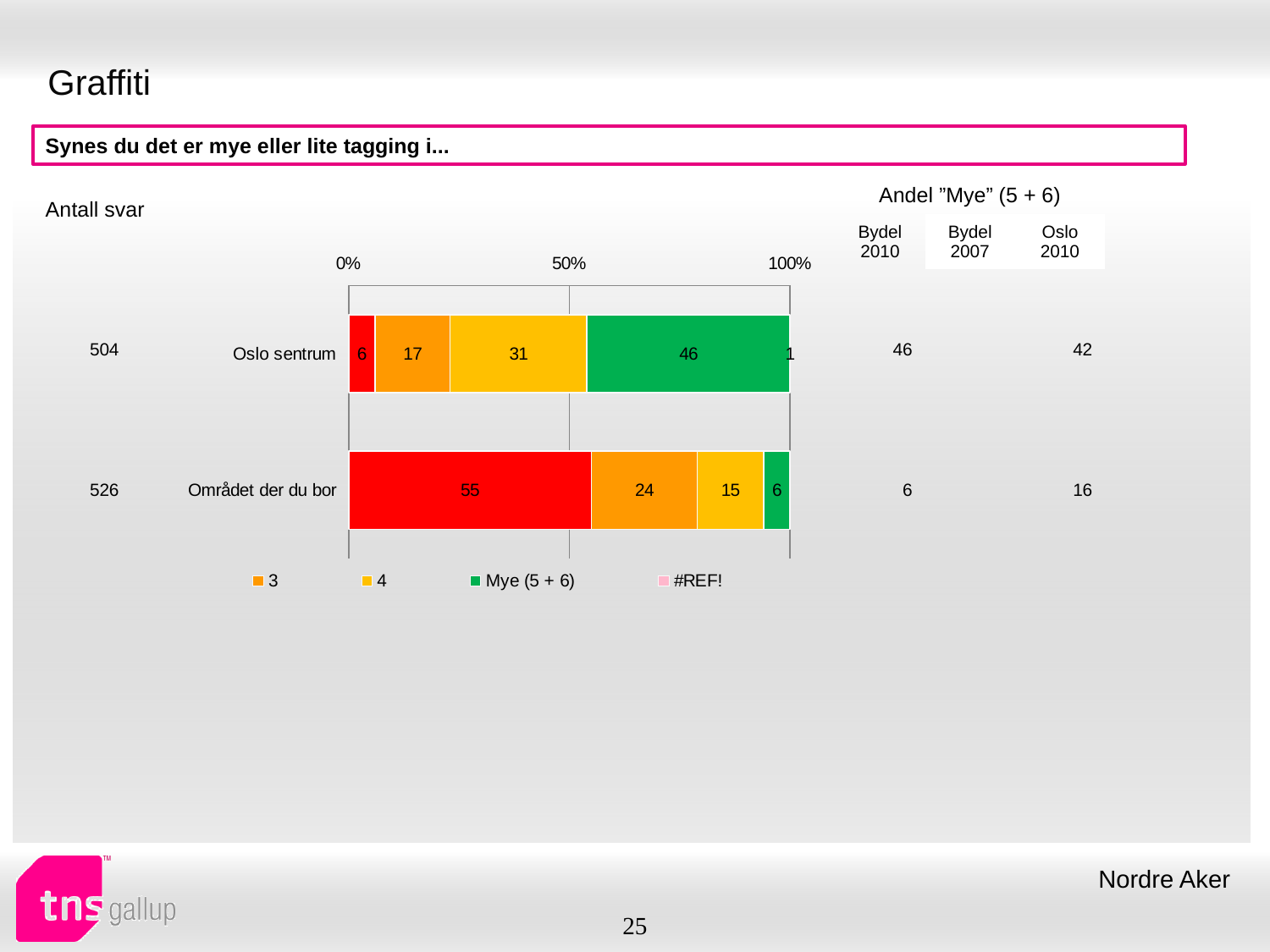
What is the value of the '3' segment for Området der du bor? 24 What is the value of the red segment for Området der du bor? 55 What is the value of the '4' segment for Oslo sentrum? 31 In the 'Andel "Mye" (5 + 6)' table, what is the Oslo 2010 value for Oslo sentrum? 42 Which category has the larger 'Mye (5 + 6)' segment, Oslo sentrum or Området der du bor? Oslo sentrum What is the value of the 'Mye (5 + 6)' segment for Oslo sentrum? 46 How many categories are plotted in the bar chart? 2 What is the difference between the 'Mye (5 + 6)' values for Oslo sentrum and Området der du bor? 40 What is the value of the 'Mye (5 + 6)' segment for Området der du bor? 6 What is the third legend entry listed below the chart? Mye (5 + 6) What kind of chart is shown on the slide? stacked bar chart What is the 'Antall svar' (number of responses) shown for Området der du bor? 526